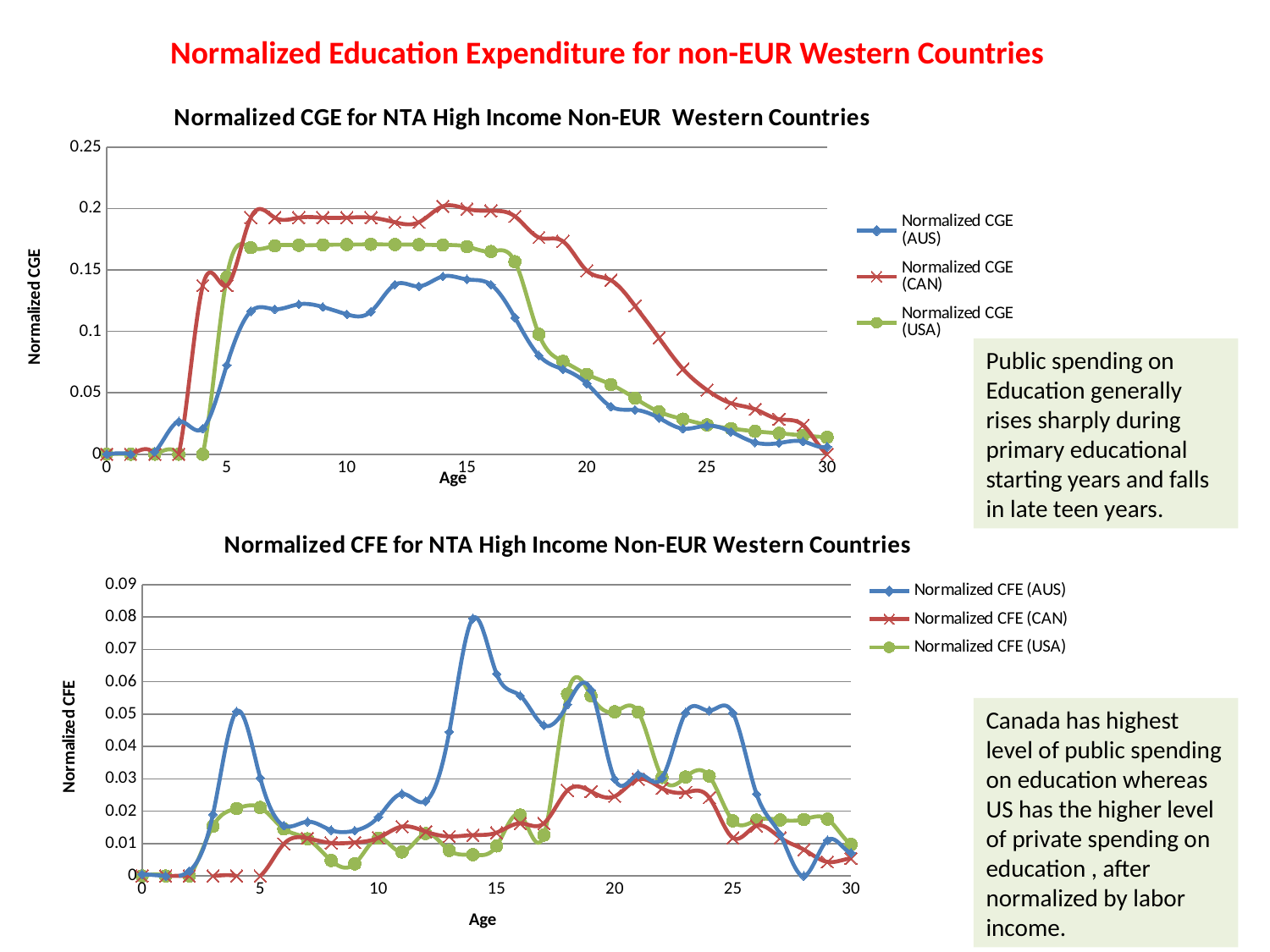
In the bottom chart (Normalized CFE), is the value for Normalized CFE (AUS) at age 14 greater or less than 0.07? greater In the top chart (Normalized CGE), is the value for Normalized CGE (CAN) at age 14 greater or less than 0.15? greater What is the x-axis title of the bottom chart (Normalized CFE)? Age In the bottom chart (Normalized CFE), at age 4, which is larger: Normalized CFE (AUS) or Normalized CFE (USA)? Normalized CFE (AUS) In the bottom chart (Normalized CFE), is the value for Normalized CFE (CAN) at age 10 greater or less than 0.02? less In the top chart (Normalized CGE), does the Normalized CGE (CAN) line rise or fall between age 20 and age 30? fall In the top chart (Normalized CGE), at age 10, which is larger: Normalized CGE (CAN) or Normalized CGE (USA)? Normalized CGE (CAN) How many series does the legend of the bottom chart (Normalized CFE) list? 3 How many series does the legend of the top chart (Normalized CGE) list? 3 What kind of chart is the top chart, 'Normalized CGE for NTA High Income Non-EUR Western Countries'? line chart In the top chart (Normalized CGE), which series has the highest value at age 20? Normalized CGE (CAN)